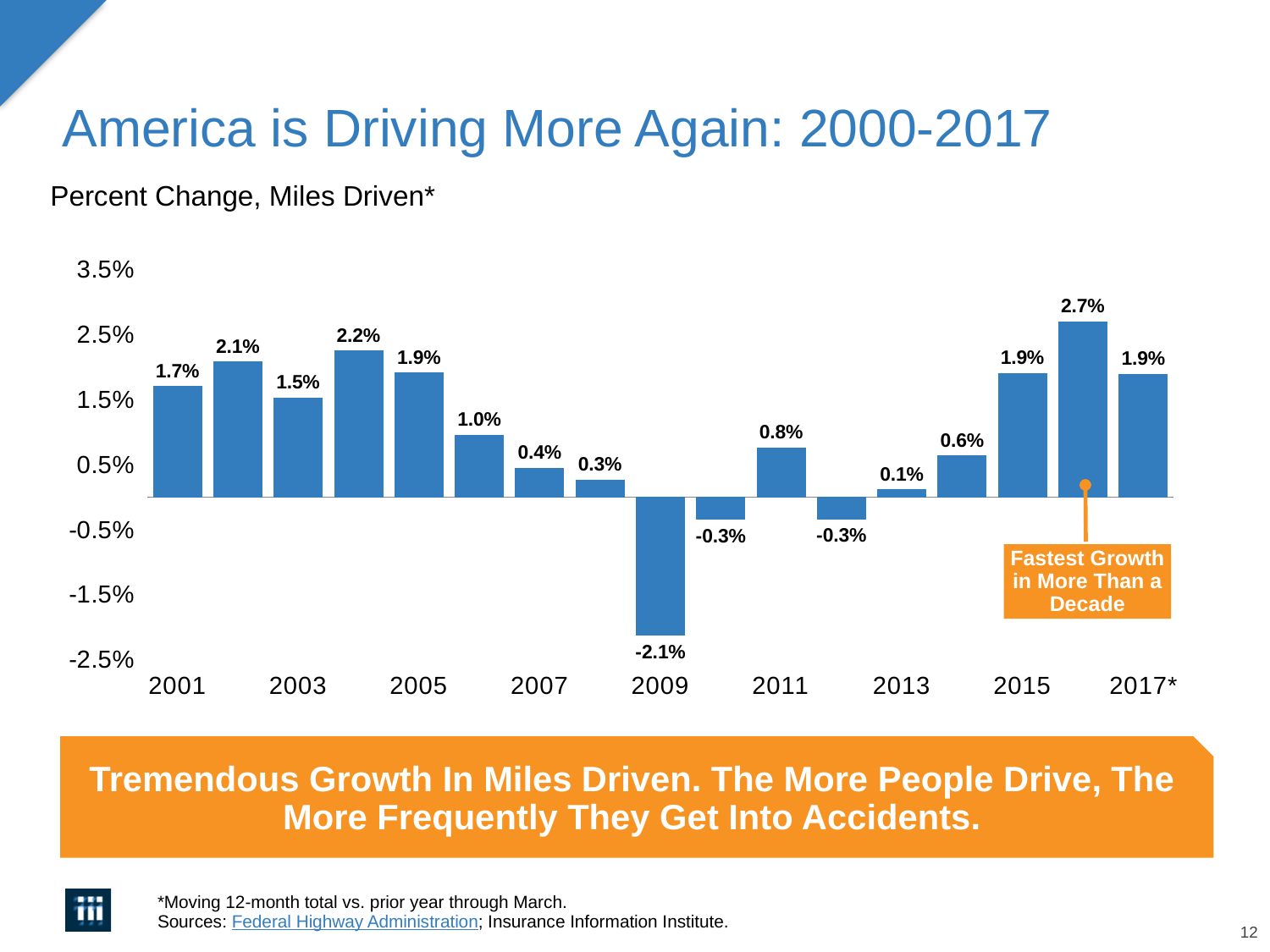
What is the percent change in miles driven for 2013? 0.1% What value is shown for the bar labelled 'Fastest Growth in More Than a Decade'? 2.7% Which year has the larger percent change, 2011 or 2013? 2011 What is the percent change in miles driven for 2009? -2.1% How many bars are plotted on the chart? 17 What is the subtitle describing the measure plotted on the chart? Percent Change, Miles Driven* What is the percent change in miles driven for 2001? 1.7% Which year has the lowest percent change in miles driven? 2009 What is the difference between the percent change in 2005 and in 2007? 1.5% What is the highest percent change shown on the chart? 2.7% What is the percent change in miles driven for 2017*? 1.9% What type of chart is shown on the slide? Bar chart